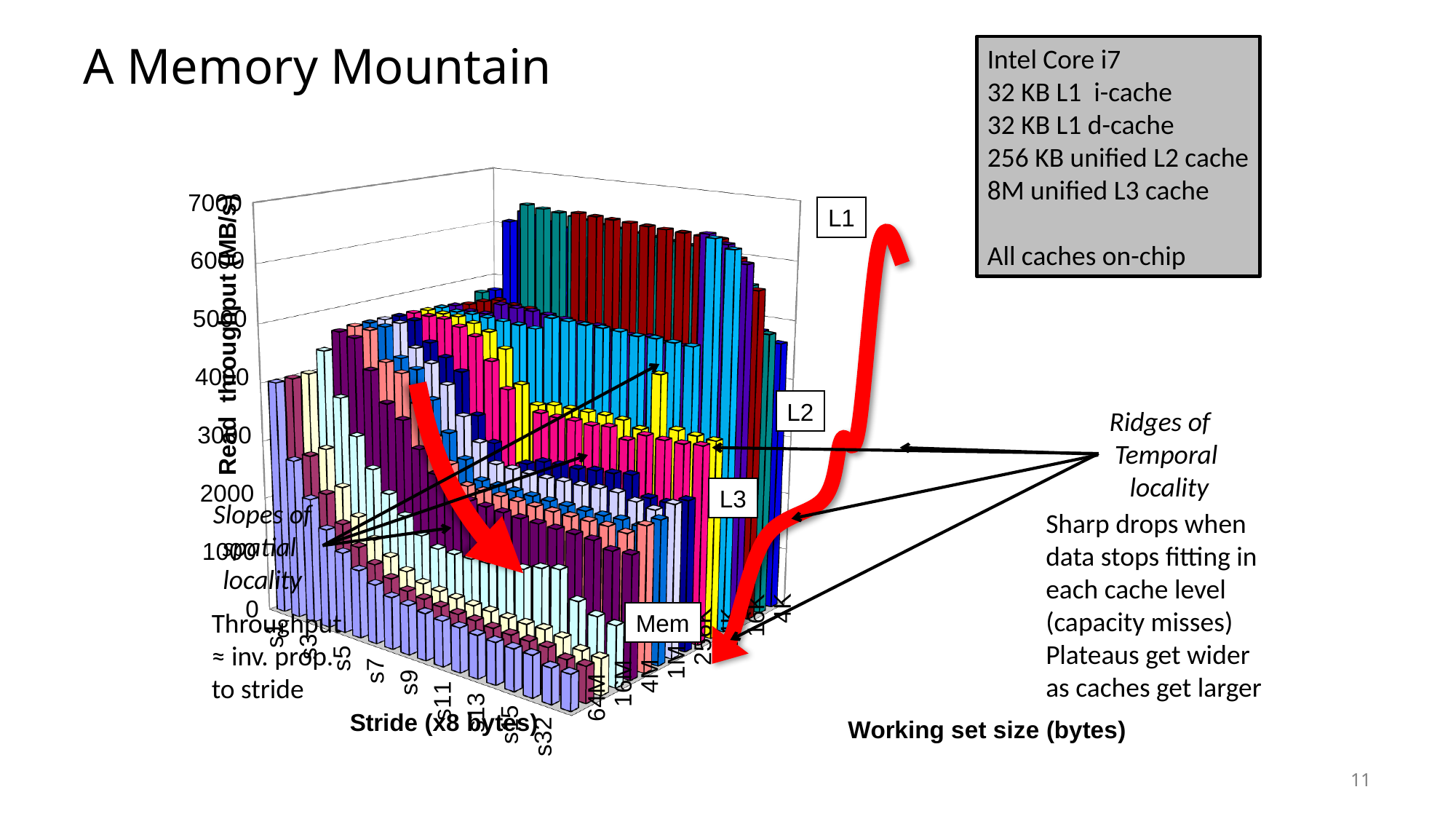
What is the highest tick value shown on the Read throughput axis? 7000 What is the label of the vertical axis of the chart? Read throughput (MB/s) What is the lowest tick value shown on the Read throughput axis? 0 What is the label of the axis showing stride values? Stride (x8 bytes) Is the read throughput for stride s1 at working set size 64M greater or less than 6000 MB/s? less What kind of chart is shown on the slide? 3D bar chart Does read throughput generally rise or fall as the working set size increases from 4K to 64M? fall Is the read throughput of the tallest bars on the L1 ridge greater or less than 5000 MB/s? greater Does read throughput generally rise or fall as the stride increases? fall Which cache level label is placed at the highest ridge of the chart? L1